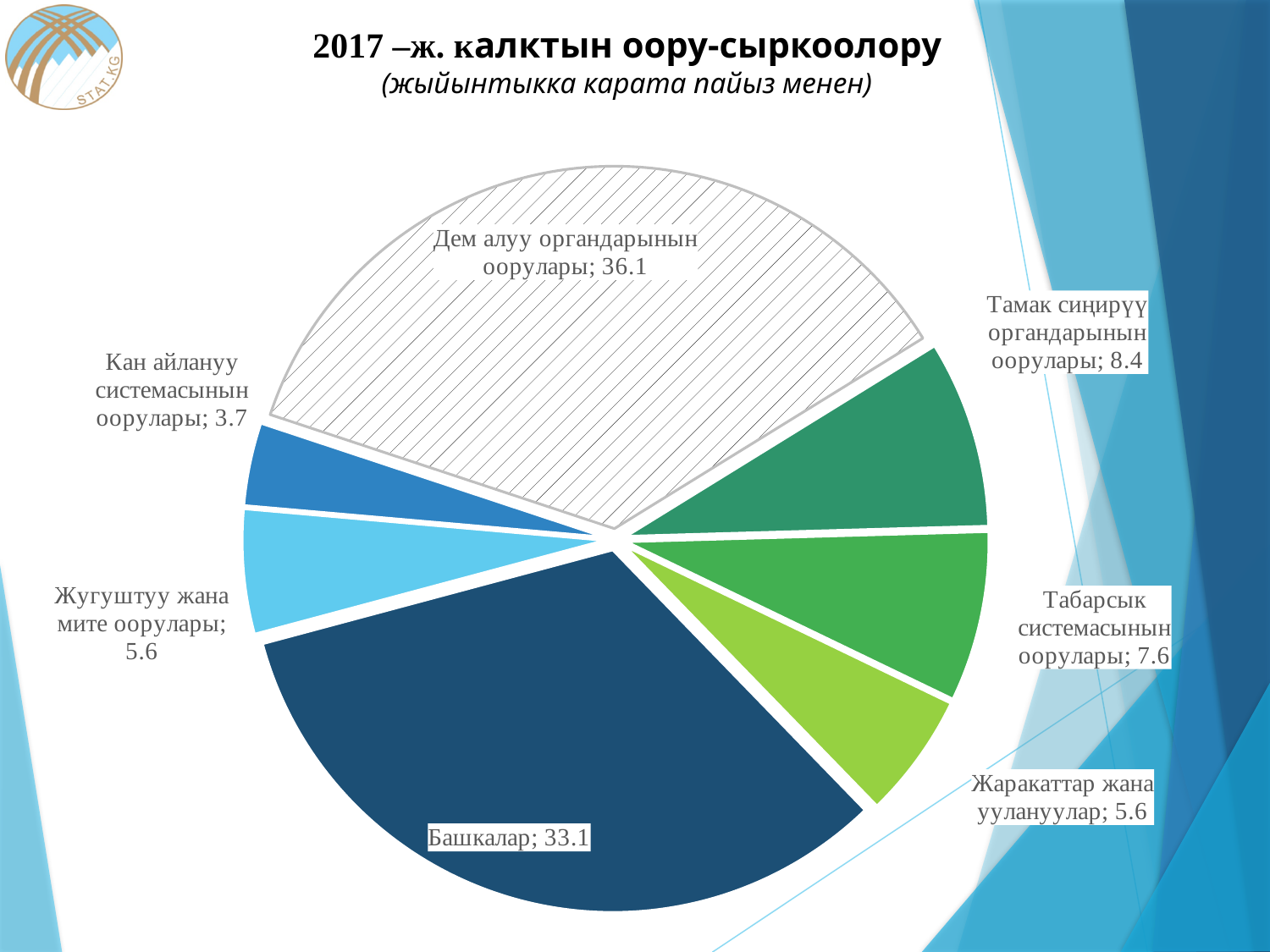
What is the value for "Башкалар"? 33.1 What is the difference between the values for "Дем алуу органдарынын оорулары" and "Башкалар"? 3.0 Which category has the smallest slice of the pie? Кан айлануу системасынын оорулары What is the value for "Кан айлануу системасынын оорулары"? 3.7 How many slices does the pie chart have? 7 Which category has the largest slice of the pie? Дем алуу органдарынын оорулары What is the difference between the values for "Тамак сиңирүү органдарынын оорулары" and "Табарсык системасынын оорулары"? 0.8 Which slice of the pie is drawn with a hatched (striped) pattern? Дем алуу органдарынын оорулары What type of chart is shown on the slide? pie chart What is the value for "Тамак сиңирүү органдарынын оорулары"? 8.4 What is the value for "Дем алуу органдарынын оорулары"? 36.1 Which is larger: the value for "Табарсык системасынын оорулары" or the value for "Жаракаттар жана уулануулар"? Табарсык системасынын оорулары